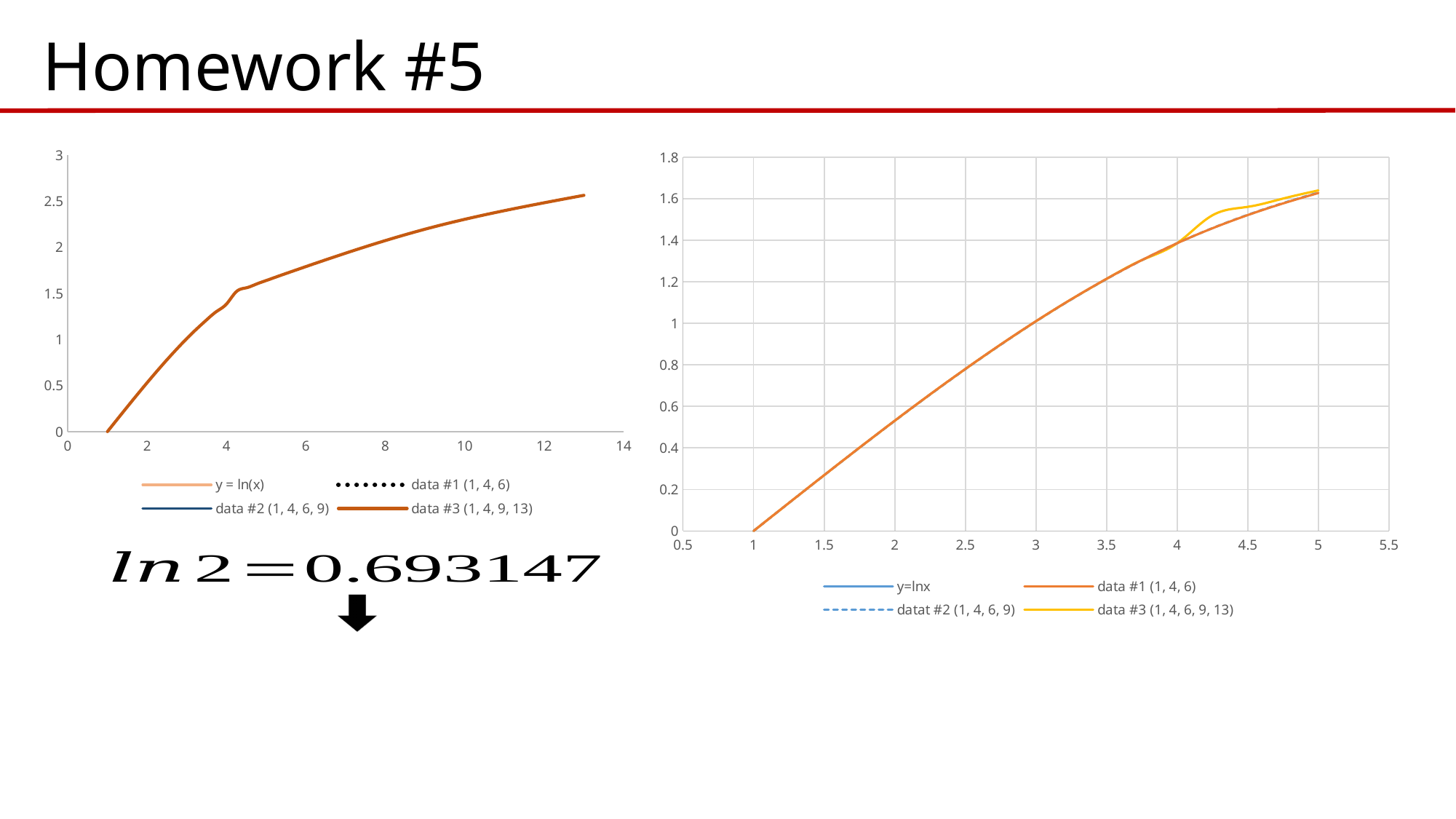
In the right chart, what is the plotted value at x = 1? 0 In the right chart, which legend entry is drawn with a dashed line? datat #2 (1, 4, 6, 9) In the left chart, is the plotted value at x = 13 greater or less than 2? greater In the right chart, do the plotted values rise or fall as x increases? rise How many series does the legend of the right chart list? 4 In the left chart, what is the plotted value at x = 1? 0 In the right chart, what colour is the line for data #3 (1, 4, 6, 9, 13)? yellow How many series does the legend of the left chart list? 4 What kind of chart is the chart on the left of the slide? line chart In the right chart, is the plotted value at x = 5 greater or less than 1.4? greater In the left chart, do the plotted values rise or fall as x increases? rise What kind of chart is the chart on the right of the slide? line chart